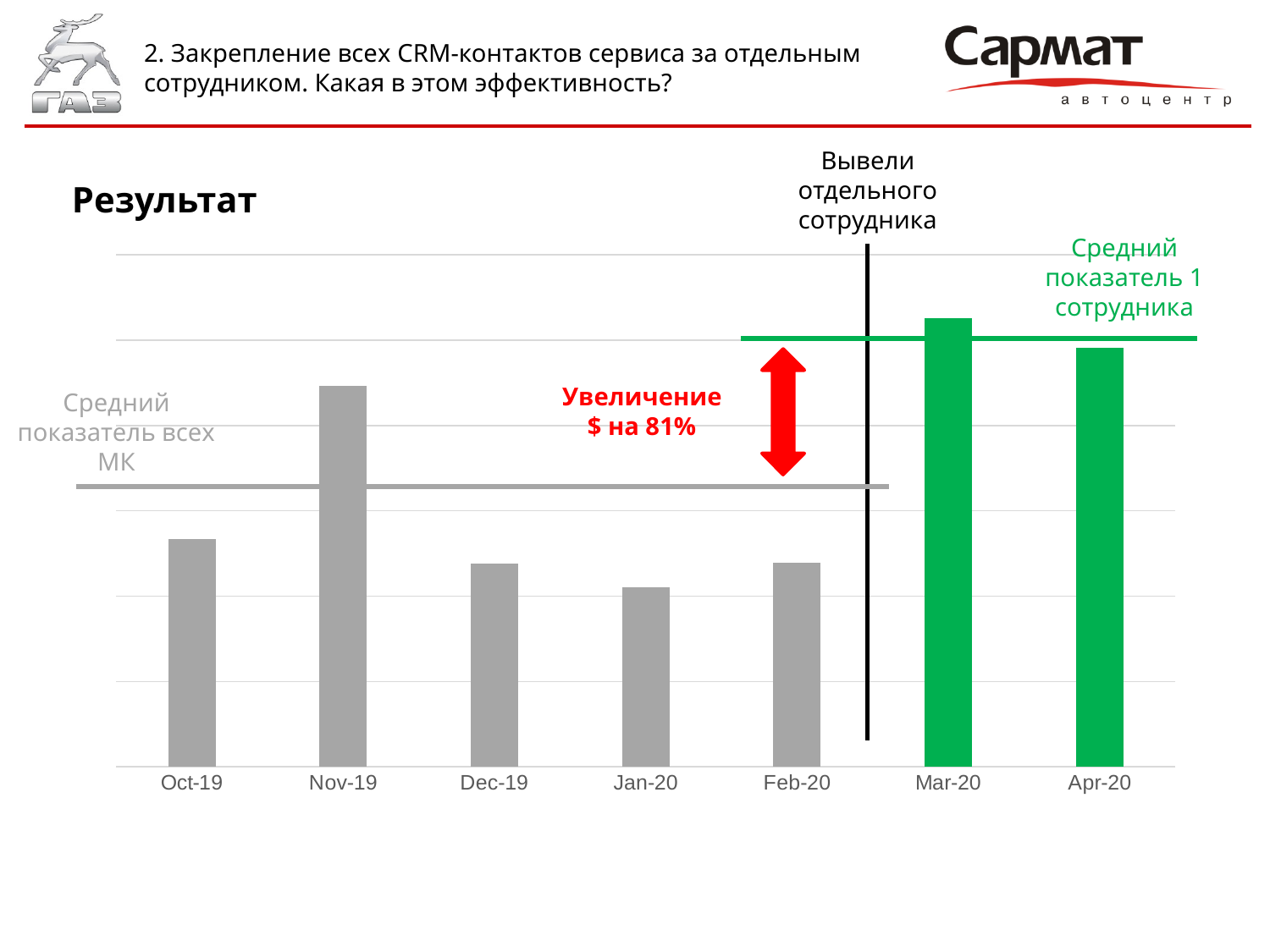
Do the bars rise or fall from Jan-20 to Mar-20? Rise Do the bars rise or fall from Nov-19 to Jan-20? Fall Which month has a higher bar, Nov-19 or Feb-20? Nov-19 What kind of chart is shown on the slide? Bar chart How many months are shown on the x axis of the chart? 7 Which month has a higher bar, Mar-20 or Apr-20? Mar-20 Which month has the highest bar in the chart? Mar-20 Which month has a higher bar, Dec-19 or Jan-20? Dec-19 What percentage increase is stated by the red annotation on the chart? 81% Which months are shown with green bars in the chart? Mar-20 and Apr-20 Which month has the lowest bar in the chart? Jan-20